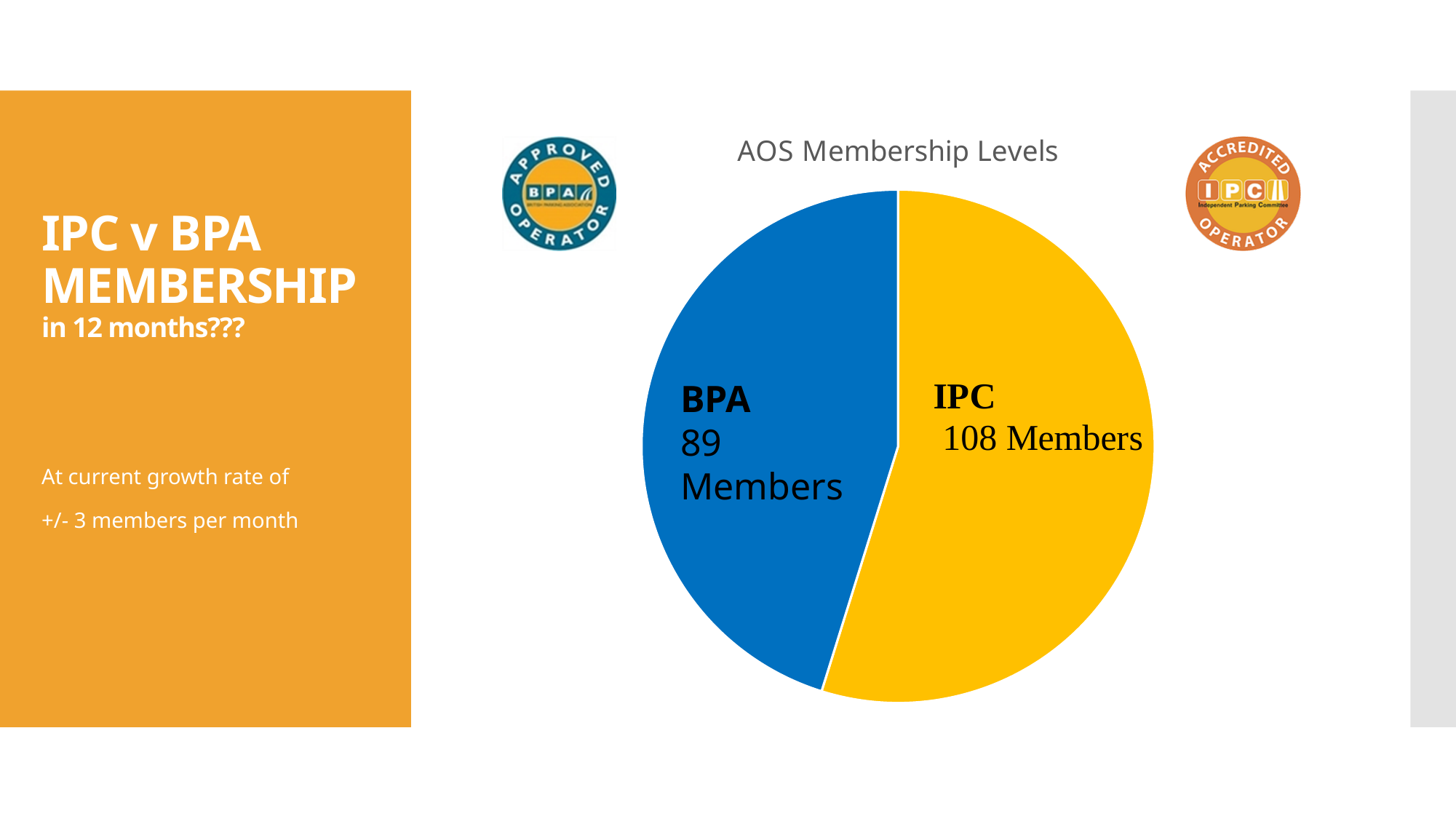
What colour is the IPC slice of the pie? yellow How many members does BPA have according to the chart? 89 Members What is the total number of members across both slices of the pie? 197 What type of chart is shown on the slide? pie chart Which organisation has the smaller slice of the pie? BPA How many members does IPC have according to the chart? 108 Members How many more members does IPC have than BPA? 19 Which organisation has the larger slice of the pie? IPC What is the title of the chart? AOS Membership Levels Which has more members, BPA or IPC? IPC How many slices does the pie chart have? 2